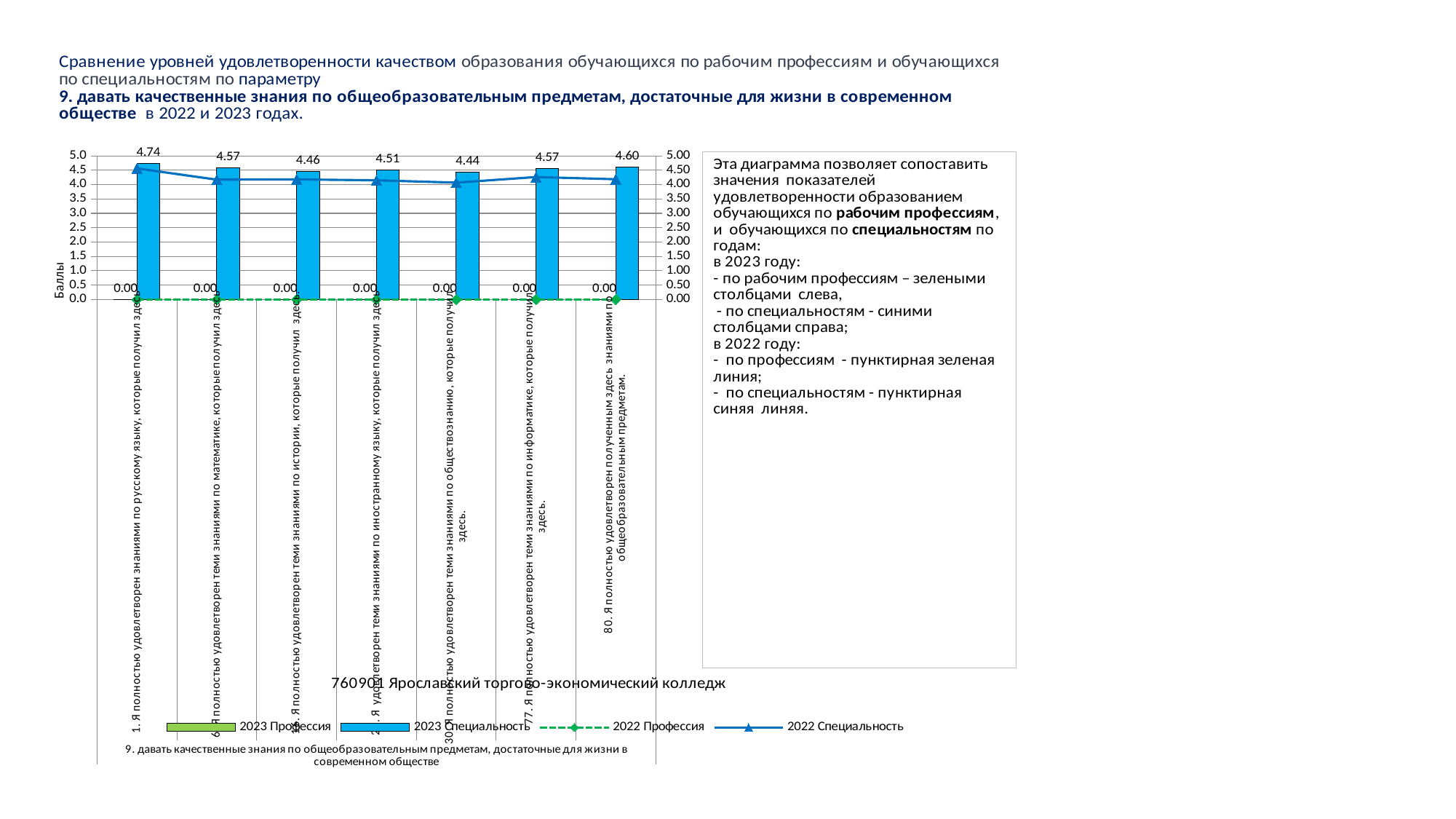
What is the 2023 Специальность value for the category about knowledge of mathematics (математике)? 4.57 What is the 2023 Специальность value for the last category, '80. Я полностью удовлетворен полученным здесь знаниями по общеобразовательным предметам'? 4.60 What is the title of the vertical axis on the left of the chart? Баллы How many series does the legend list? 4 Which category has the highest 2023 Специальность value? 1. Я полностью удовлетворен знаниями по русскому языку, которые получил здесь What is the 2023 Специальность value for the category about social studies (обществознанию)? 4.44 Which is larger: the 2023 Специальность value for иностранному языку or for истории? иностранному языку (4.51) What is the difference between the highest and lowest 2023 Специальность values? 0.30 What is the 2023 Специальность value for the category about knowledge of Russian language (русскому языку)? 4.74 What is the 2023 Специальность value for the category about knowledge of history (истории)? 4.46 How many categories are shown on the x axis of the chart? 7 Which category has the lowest 2023 Специальность value? The category about knowledge of обществознанию (social studies), 4.44